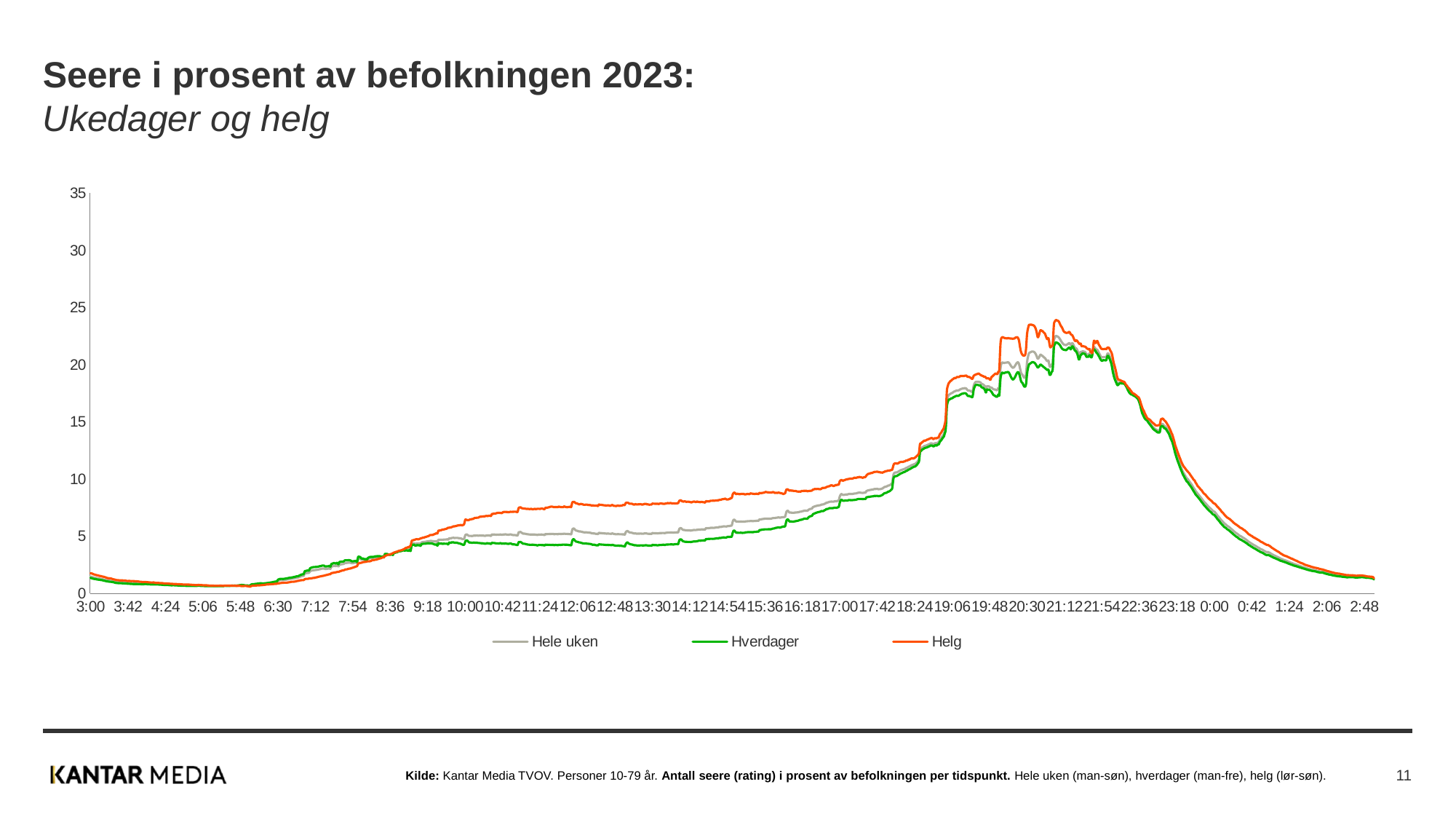
At 15:36, which is larger: Helg or Hverdager? Helg What colour is the Helg line? orange Is the peak value of the Helg line greater or less than 25? less Which series reaches the highest peak in the evening? Helg Is the value for Helg at 12:06 greater or less than 5? greater Is the value for Helg at 20:30 greater or less than 20? greater What kind of chart is shown on the slide? line chart What are the three series named in the legend? Hele uken, Hverdager, Helg Do the values fall or rise along the x axis from 21:54 to 2:48? fall Do the values rise or fall along the x axis from 5:48 to 9:18? rise How many series does the legend list? 3